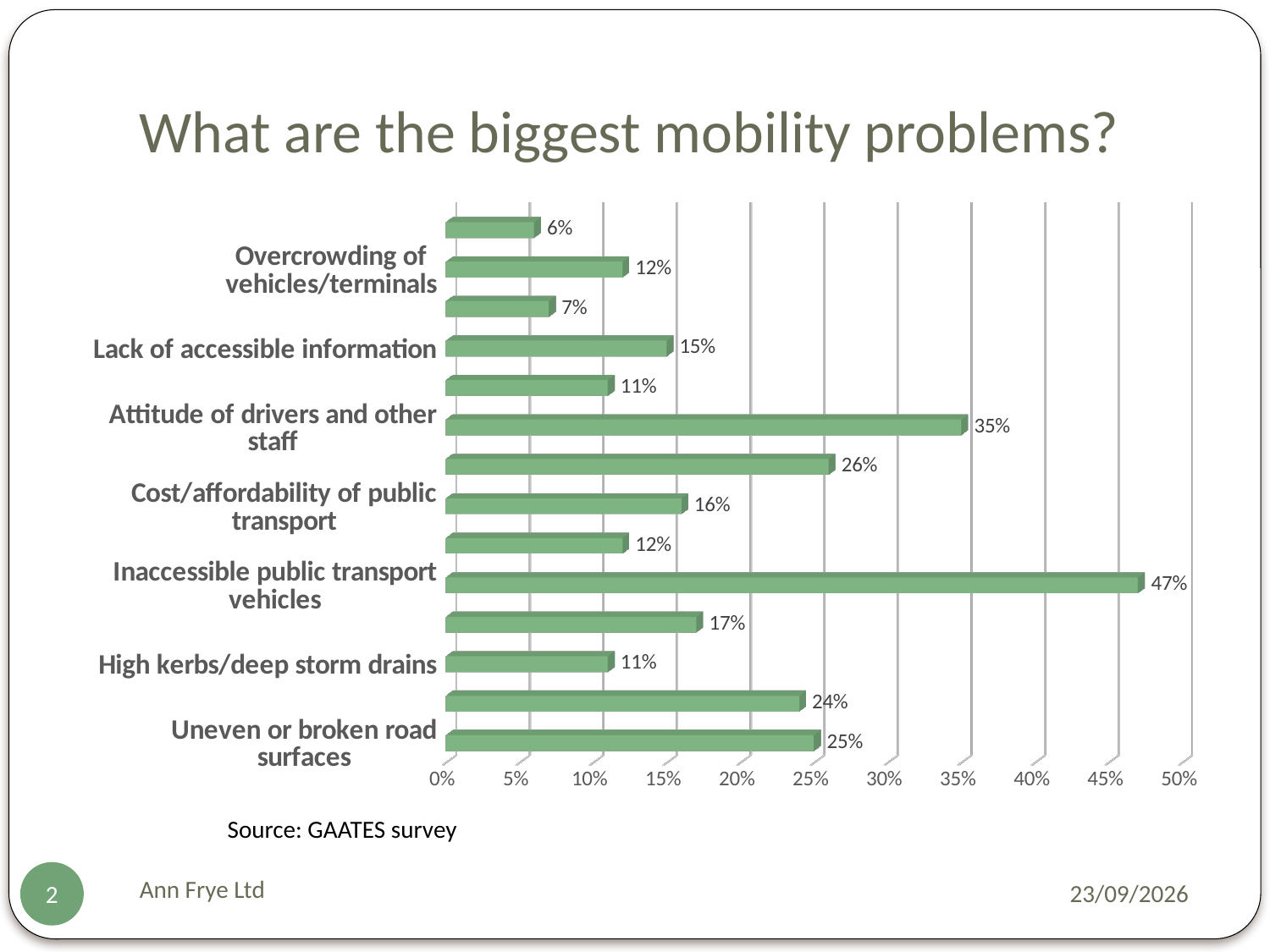
What is the difference between the values for Inaccessible public transport vehicles and Attitude of drivers and other staff? 12% What is the value for Lack of accessible information? 15% How many bars are plotted in the chart? 14 What type of chart is shown on the slide? bar chart What is the smallest value shown on any bar in the chart? 6% What is the value for Attitude of drivers and other staff? 35% What is the title of the slide? What are the biggest mobility problems? What is the value for Inaccessible public transport vehicles? 47% Which is larger, the value for Cost/affordability of public transport or the value for Uneven or broken road surfaces? Uneven or broken road surfaces Which labelled category has the highest value? Inaccessible public transport vehicles What is the value for High kerbs/deep storm drains? 11% What is the value for Uneven or broken road surfaces? 25%